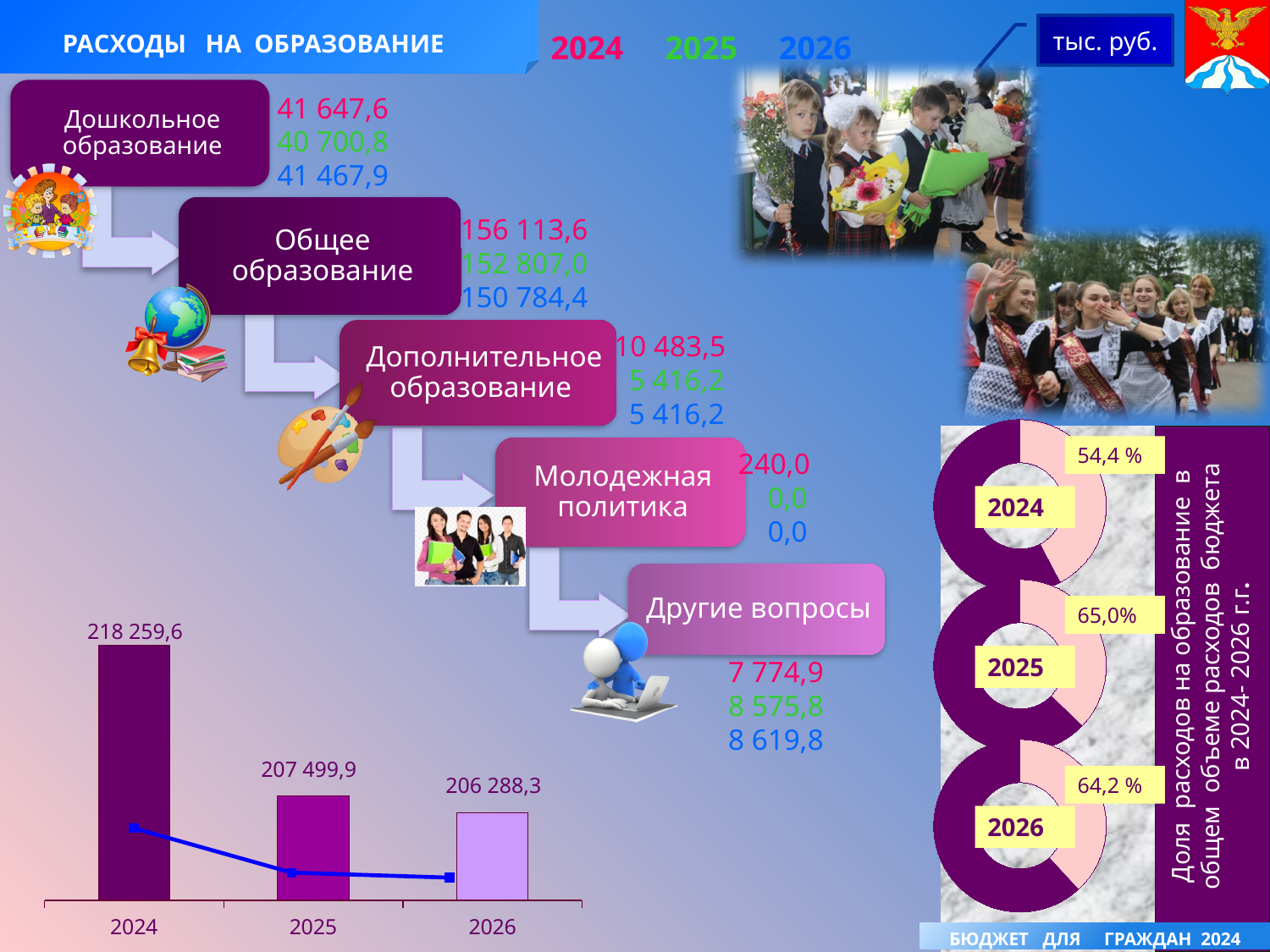
In the bar chart at the bottom left, do the values rise or fall from 2024 to 2026? fall In the bar chart at the bottom left, which year has the highest value? 2024 In the bar chart at the bottom left, what is the value for 2025? 207 499,9 In the bar chart at the bottom left, which is larger: the value for 2024 or the value for 2026? 2024 In the bar chart at the bottom left, what is the value for 2026? 206 288,3 In the bar chart at the bottom left, which year has the lowest value? 2026 In the bar chart at the bottom left, what is the value for 2024? 218 259,6 In the bar chart at the bottom left, what is the difference between the values for 2024 and 2025? 10 759,7 In the bar chart at the bottom left, what is the difference between the values for 2025 and 2026? 1 211,6 In the bar chart at the bottom left, what is the difference between the values for 2024 and 2026? 11 971,3 How many years (categories) are shown in the bar chart at the bottom left? 3 What kind of chart is shown at the bottom left of the slide? bar chart